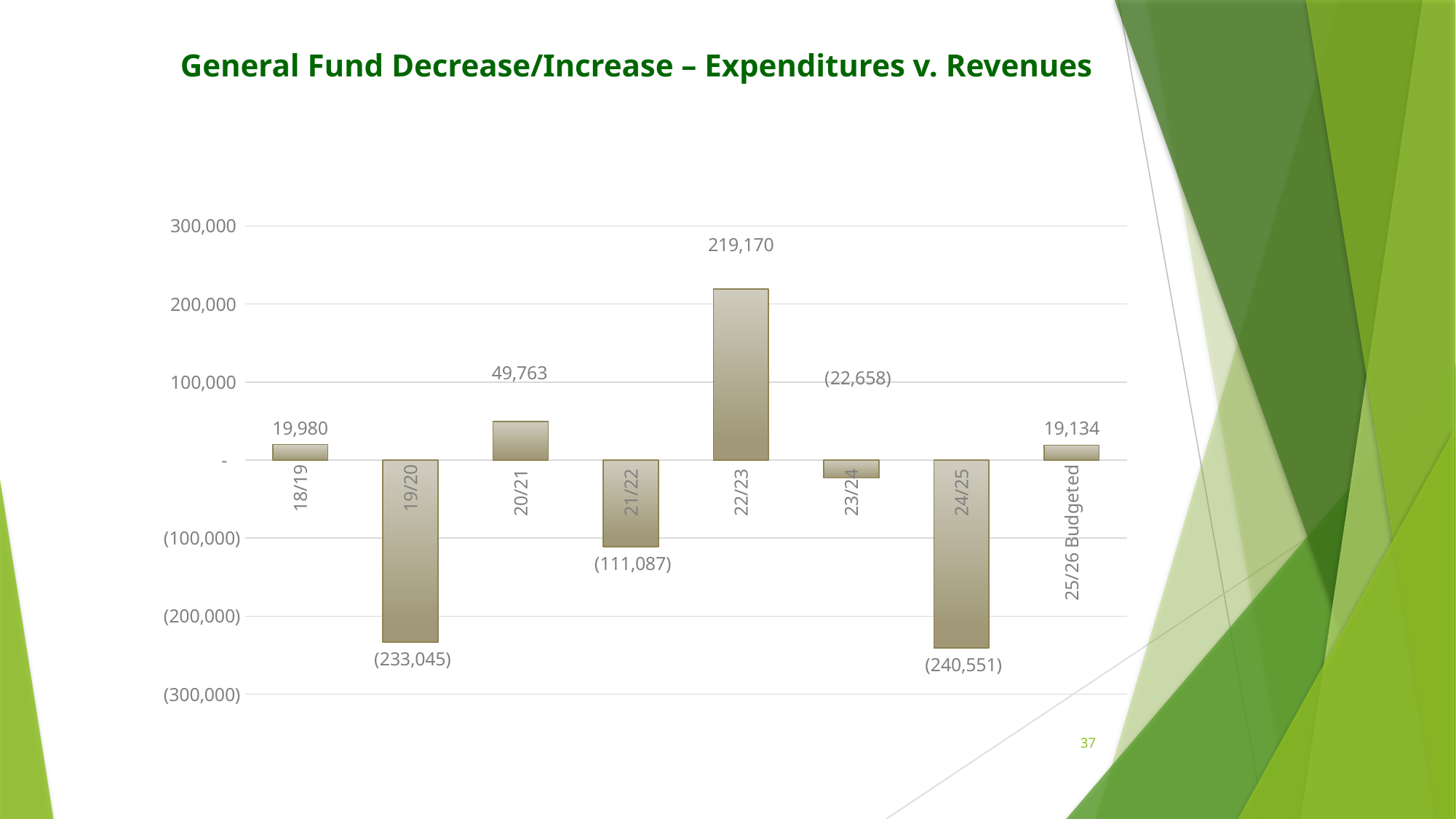
What is the value for 22/23? 219,170 What is the difference between the values for 18/19 and 25/26 Budgeted? 846 What is the value for 21/22? (111,087) Which year has the highest value? 22/23 What kind of chart is shown on the slide? Bar chart What is the value for 25/26 Budgeted? 19,134 What is the title of the chart? General Fund Decrease/Increase – Expenditures v. Revenues What is the value for 19/20? (233,045) Which is larger, the value for 20/21 or the value for 18/19? 20/21 Which year has the lowest value? 24/25 What is the difference between the values for 22/23 and 20/21? 169,407 How many years are shown on the x axis? 8